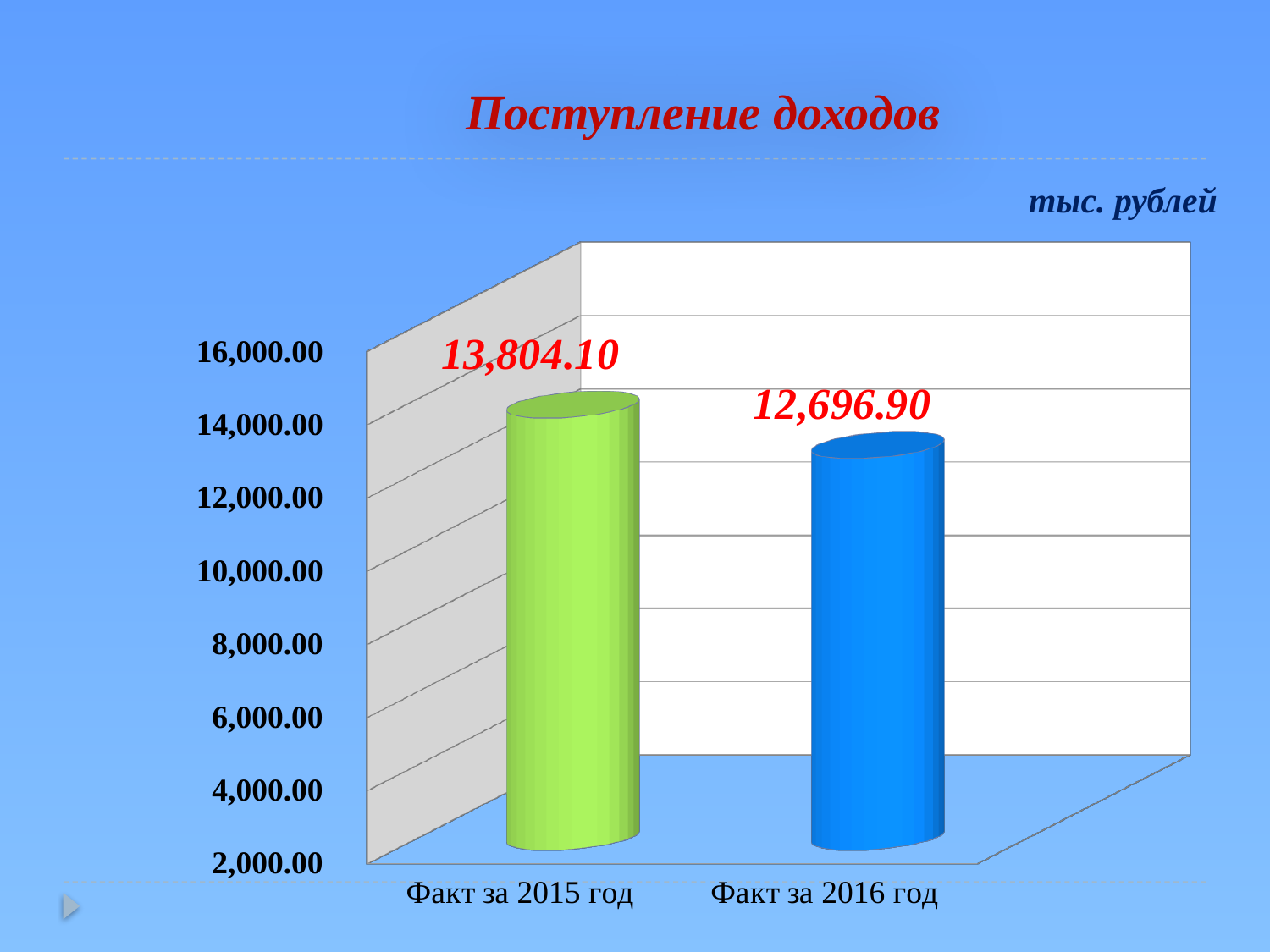
Which is larger, the value for Факт за 2015 год or Факт за 2016 год? Факт за 2015 год What kind of chart is shown on the slide? bar chart Which category has the highest value? Факт за 2015 год What is the difference between the values for Факт за 2015 год and Факт за 2016 год? 1,107.20 Is the value for Факт за 2015 год greater or less than 12,000.00? greater What is the title of the chart? Поступление доходов What is the value for Факт за 2015 год? 13,804.10 How many categories are shown on the chart? 2 Do the values rise or fall from Факт за 2015 год to Факт за 2016 год? fall Is the value for Факт за 2016 год greater or less than 14,000.00? less Which category has the lowest value? Факт за 2016 год What is the value for Факт за 2016 год? 12,696.90